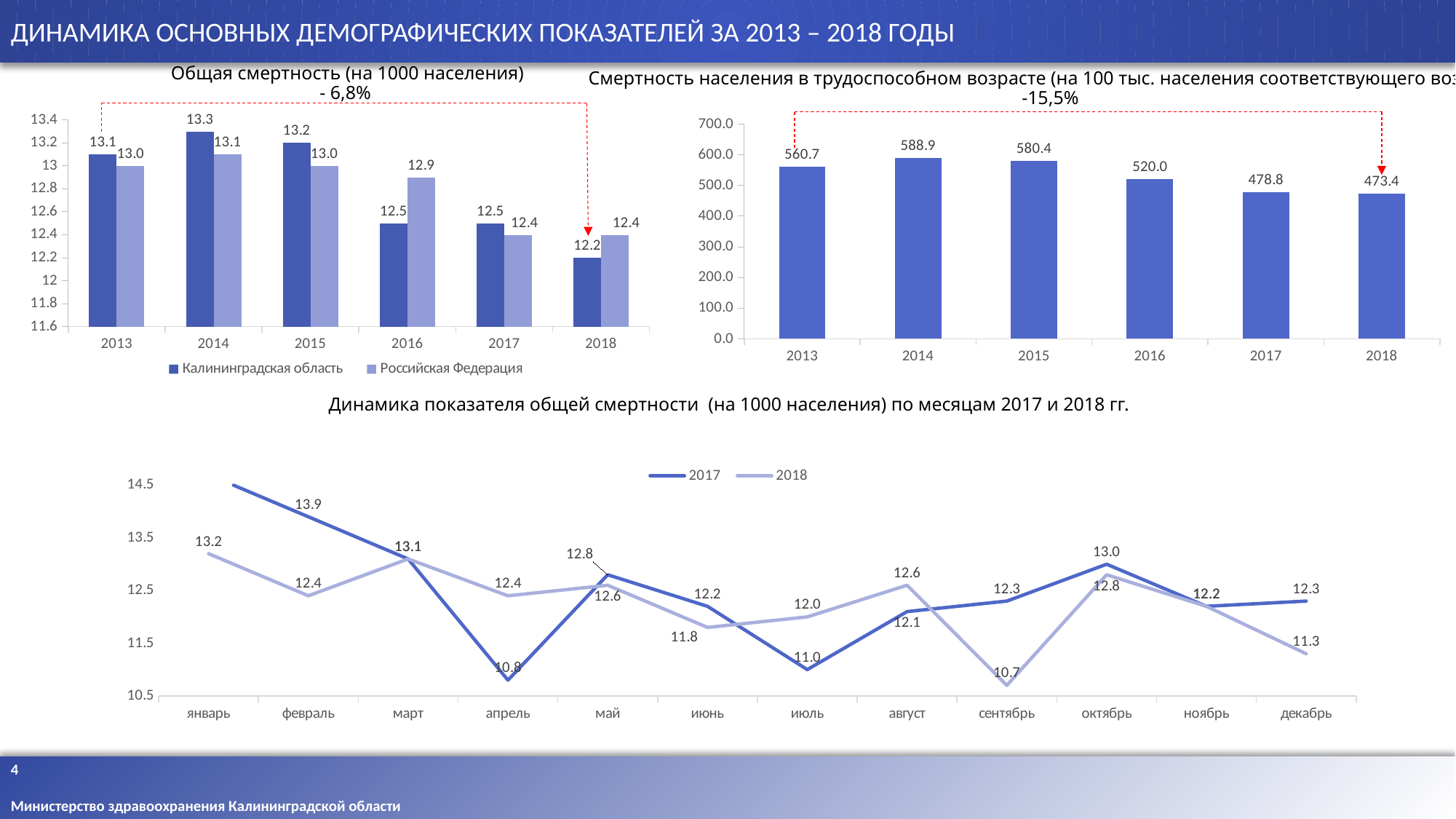
In the bottom line chart, what is the value for 2018 in сентябрь? 10.7 In the chart 'Общая смертность (на 1000 населения)', how many series does the legend list? 2 In the top-right chart (Смертность населения в трудоспособном возрасте), what is the difference between 2013 and 2018? 87.3 In the top-right chart (Смертность населения в трудоспособном возрасте), how many years are shown on the x axis? 6 In the chart 'Общая смертность (на 1000 населения)', what is the difference between Калининградская область and Российская Федерация in 2014? 0.2 What kind of chart is the bottom chart 'Динамика показателя общей смертности (на 1000 населения) по месяцам 2017 и 2018 гг.'? line chart In the chart 'Общая смертность (на 1000 населения)', which year has the highest value for Калининградская область? 2014 In the top-right chart (Смертность населения в трудоспособном возрасте), what is the value for 2014? 588.9 In the chart 'Общая смертность (на 1000 населения)', what is the value for Калининградская область in 2018? 12.2 In the chart 'Общая смертность (на 1000 населения)', what is the value for Российская Федерация in 2016? 12.9 In the bottom line chart, which is larger in апрель: the 2017 value or the 2018 value? 2018 In the top-right chart (Смертность населения в трудоспособном возрасте), which year has the lowest value? 2018